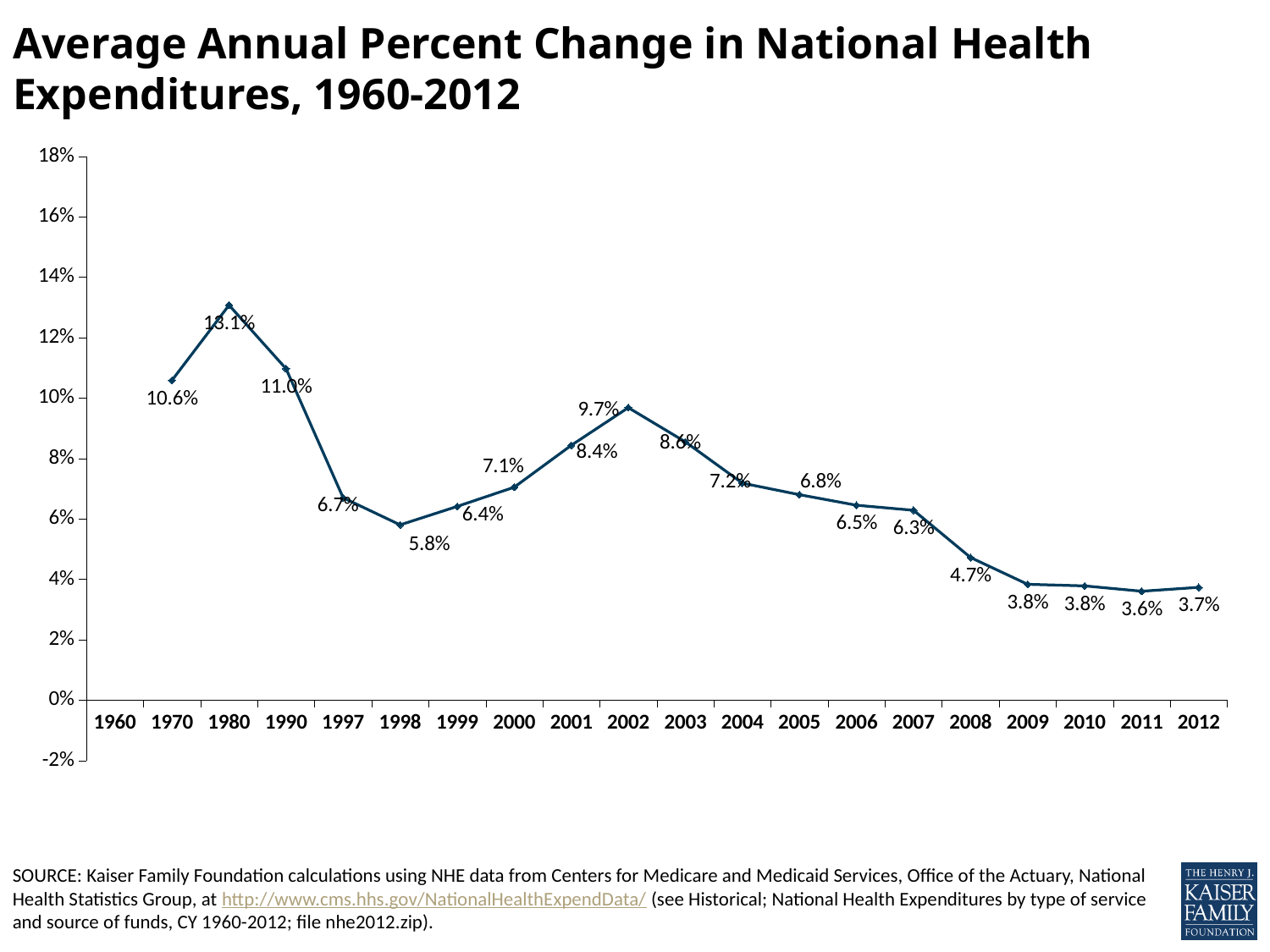
Which is larger, the value for 2002 or the value for 2003? 2002 How many year labels appear on the x axis? 20 By how many percentage points does the value for 1980 exceed the value for 1970? 2.5 percentage points Do the values rise or fall from 2002 to 2012? Fall Which year has the highest average annual percent change? 1980 Which year has the lowest average annual percent change? 2011 What kind of chart is shown on the slide? Line chart What is the average annual percent change shown for 1980? 13.1% What value is shown for 2008? 4.7% Is the value for 1990 greater or less than 10%? greater What is the value plotted for 1998? 5.8% What is the difference between the values for 2002 and 2012? 6.0 percentage points